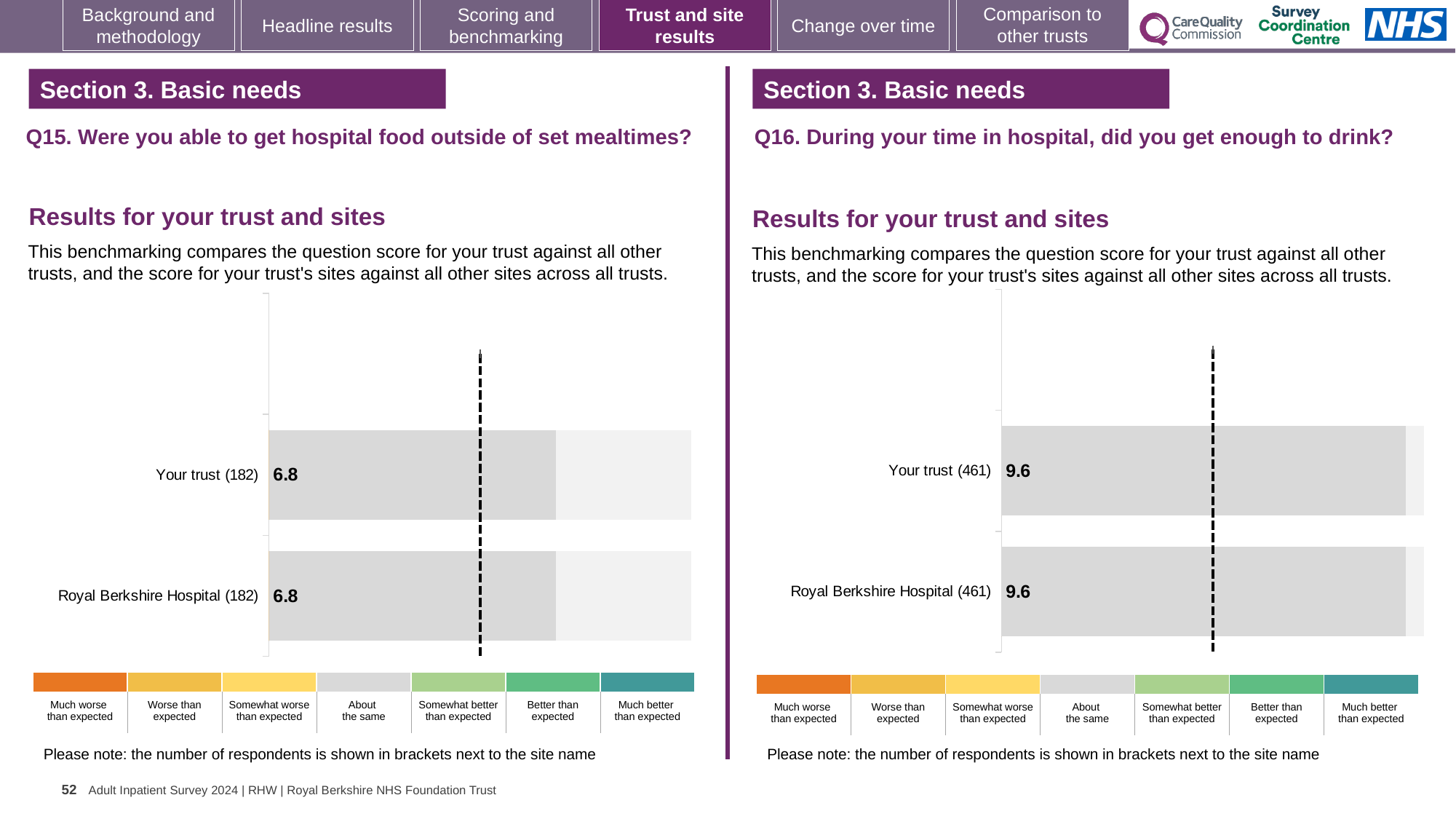
How many bars are plotted in the Q16 chart on the right? 2 What kind of chart is used for the Q15 results on the left? Bar chart How many bars are plotted in the Q15 chart on the left? 2 In the Q16 chart on the right, what is the score for Your trust? 9.6 In the Q15 chart on the left, what is the score for Royal Berkshire Hospital? 6.8 In the Q16 chart on the right, what is the difference between the score for Your trust and the score for Royal Berkshire Hospital? 0 In the Q16 chart on the right, what is the score for Royal Berkshire Hospital? 9.6 Which question does the chart on the right of the slide show results for? Q16. During your time in hospital, did you get enough to drink? In the Q15 chart on the left, what is the score for Your trust? 6.8 In the Q16 chart on the right, how many respondents are shown in brackets for Royal Berkshire Hospital? 461 In the Q15 chart on the left, what is the difference between the score for Your trust and the score for Royal Berkshire Hospital? 0 In the Q15 chart on the left, how many respondents are shown in brackets for Your trust? 182